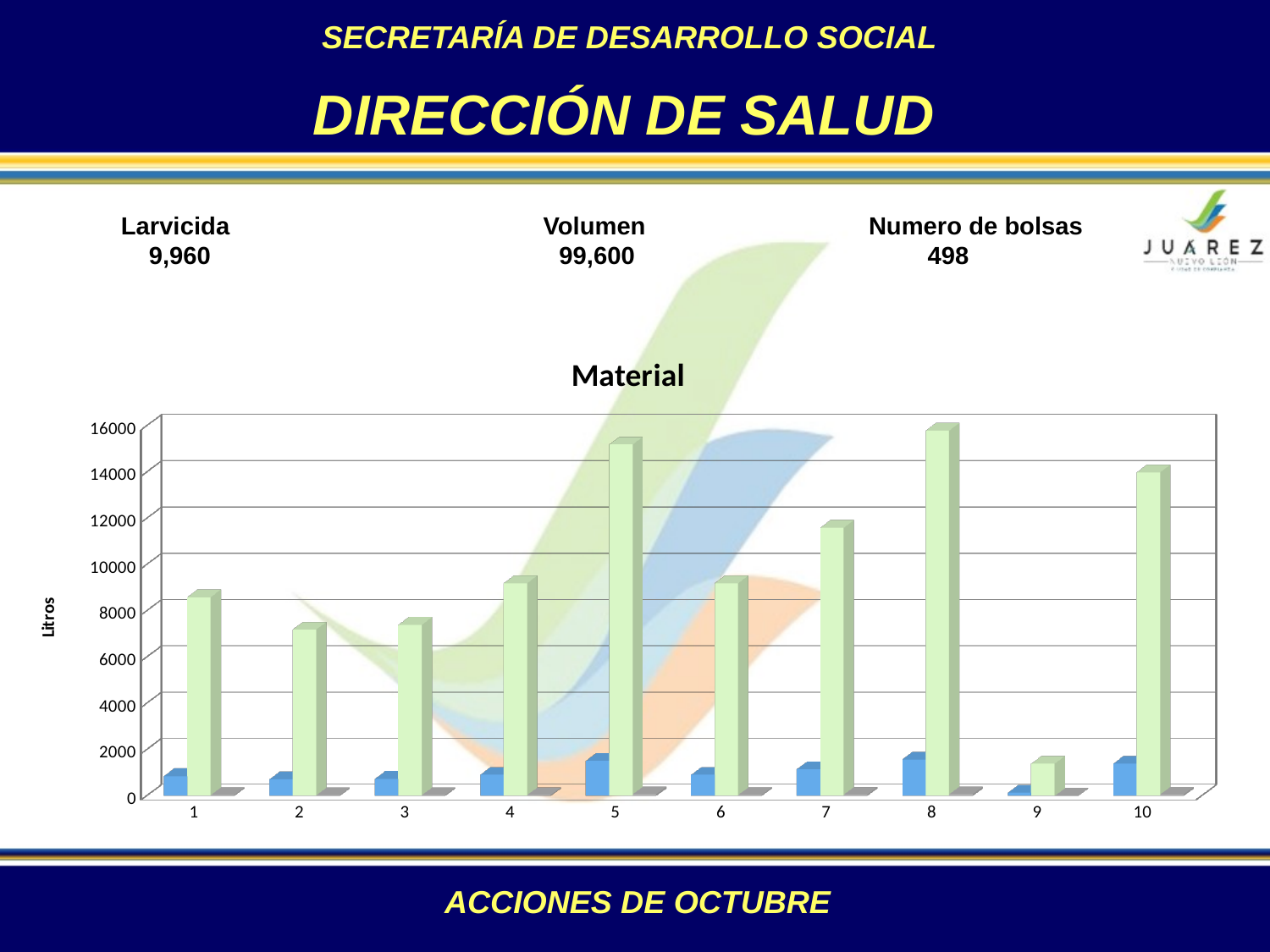
In the "Material" chart, is the green bar for category 9 greater or less than 2000? less In the "Material" chart, is the green bar for category 7 greater or less than 10000? greater In the "Material" chart, is the green bar for category 5 greater or less than 14000? greater What is the label on the vertical axis of the "Material" chart? Litros What is the title of the chart on the slide? Material In the "Material" chart, which category has the shortest green bar? 9 What kind of chart is shown under the title "Material"? bar chart How many categories are shown on the x axis of the "Material" chart? 10 In the "Material" chart, which green bar is taller: category 7 or category 4? 7 In the "Material" chart, which category has the tallest green bar? 8